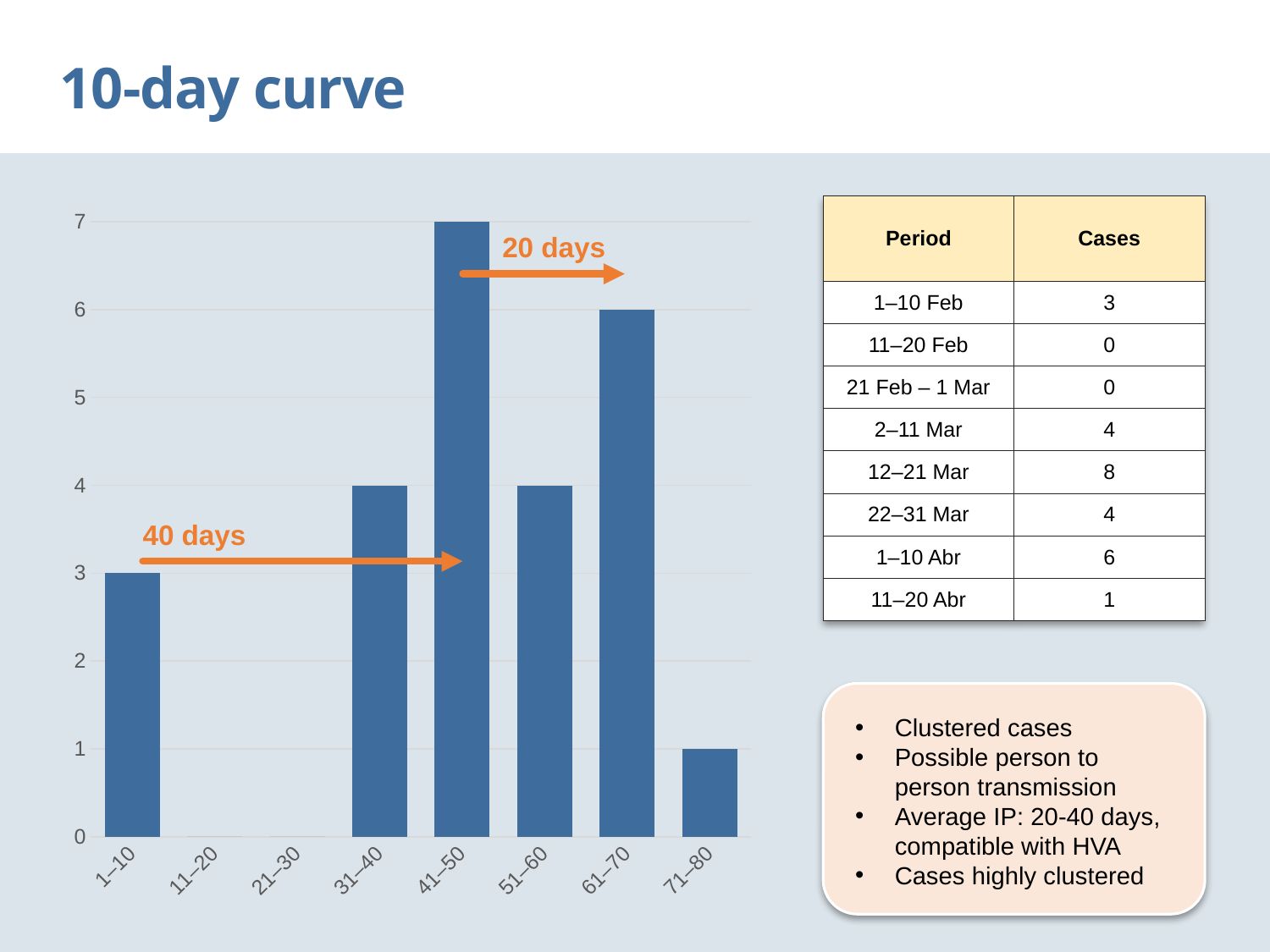
What is the value for the 1–10 category? 3 Is the value for 41–50 greater or less than 5? greater What is the difference between the values for 61–70 and 71–80? 5 What kind of chart is shown on the slide? Bar chart What is the title of the slide containing the chart? 10-day curve Which category has the highest bar? 41–50 What is the value for the 31–40 category? 4 What is the value for the 71–80 category? 1 Which is larger, the value for 61–70 or the value for 51–60? 61–70 What is the value for the 61–70 category? 6 How many categories have a value of 0? 2 How many categories are shown on the x axis? 8